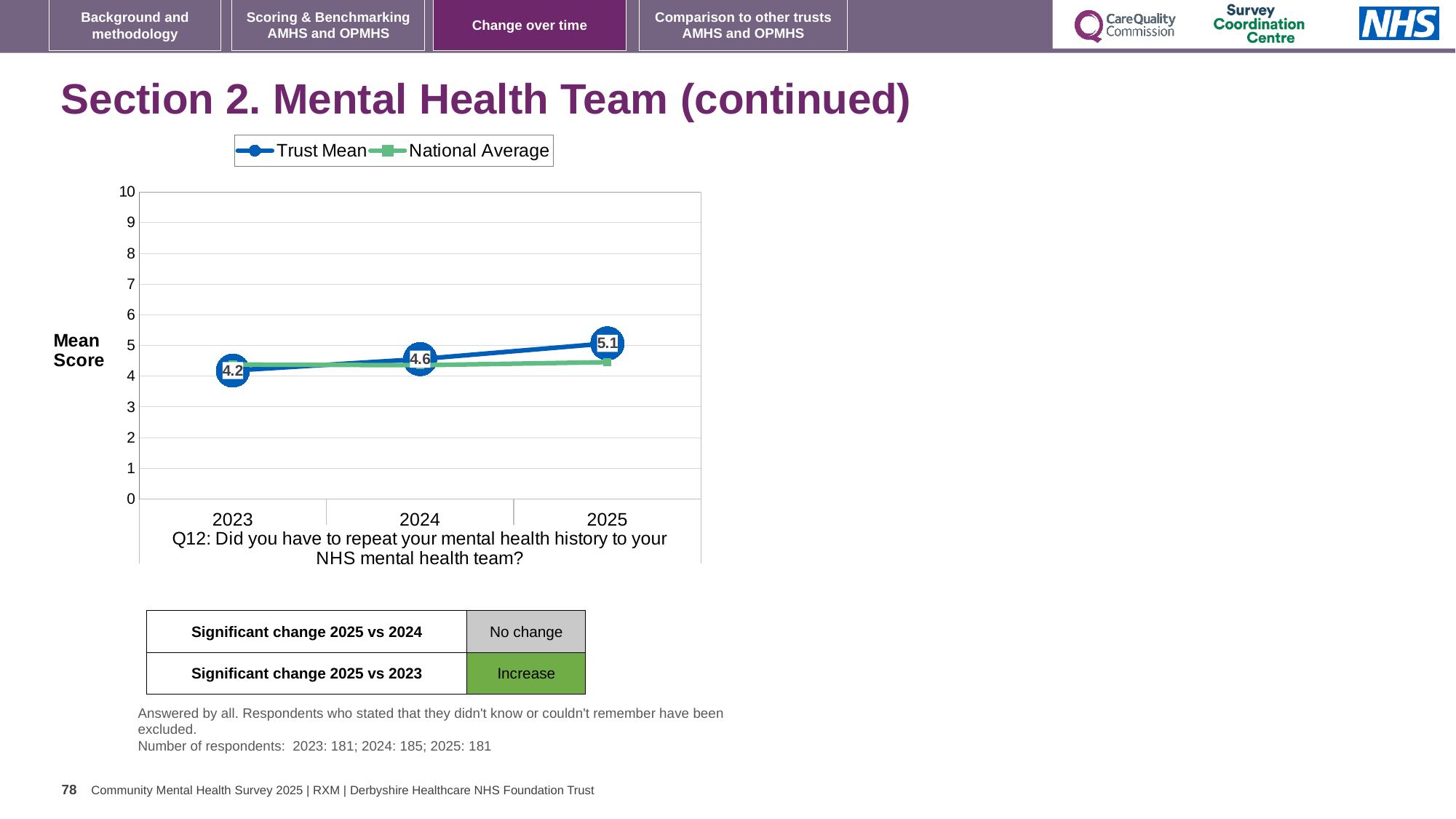
How many series does the legend list? 2 What is the difference between the Trust Mean in 2025 and in 2023? 0.9 What is the Trust Mean value for 2024? 4.6 What kind of chart is shown on the slide? line chart Does the Trust Mean rise or fall from 2023 to 2025? rise What is the Trust Mean value for 2025? 5.1 In 2025, which is larger: the Trust Mean or the National Average? Trust Mean What is the Trust Mean value for 2023? 4.2 In which year is the Trust Mean lowest? 2023 How many years are plotted on the x axis? 3 Is the National Average value for 2025 greater or less than 5? less In which year is the Trust Mean highest? 2025